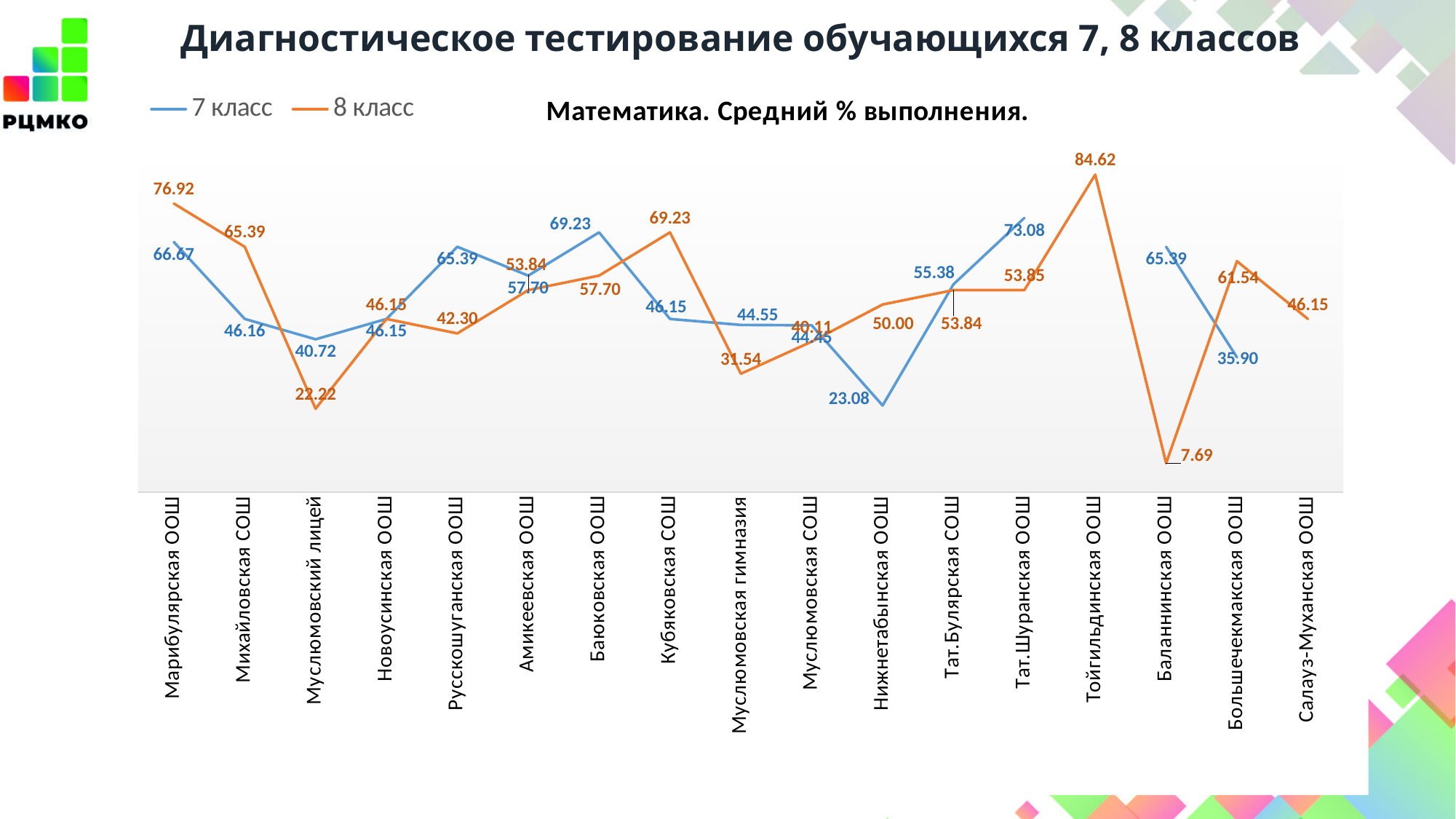
What is the value for 8 класс at Тойгильдинская ООШ? 84.62 What is the value for 7 класс at Марибулярская ООШ? 66.67 What is the difference between the 7 класс and 8 класс values at Муслюмовский лицей? 18.50 What is the value for 8 класс at Баланнинская ООШ? 7.69 Which school has the lowest value for 7 класс? Нижнетабынская ООШ What kind of chart is shown on the slide? line chart How many series does the legend list? 2 At Кубяковская СОШ, which series has the larger value, 7 класс or 8 класс? 8 класс Which school has the highest value for 7 класс? Тат.Шуранская ООШ Which school has the lowest value for 8 класс? Баланнинская ООШ Which school has the highest value for 8 класс? Тойгильдинская ООШ What is the title of the chart? Математика. Средний % выполнения.